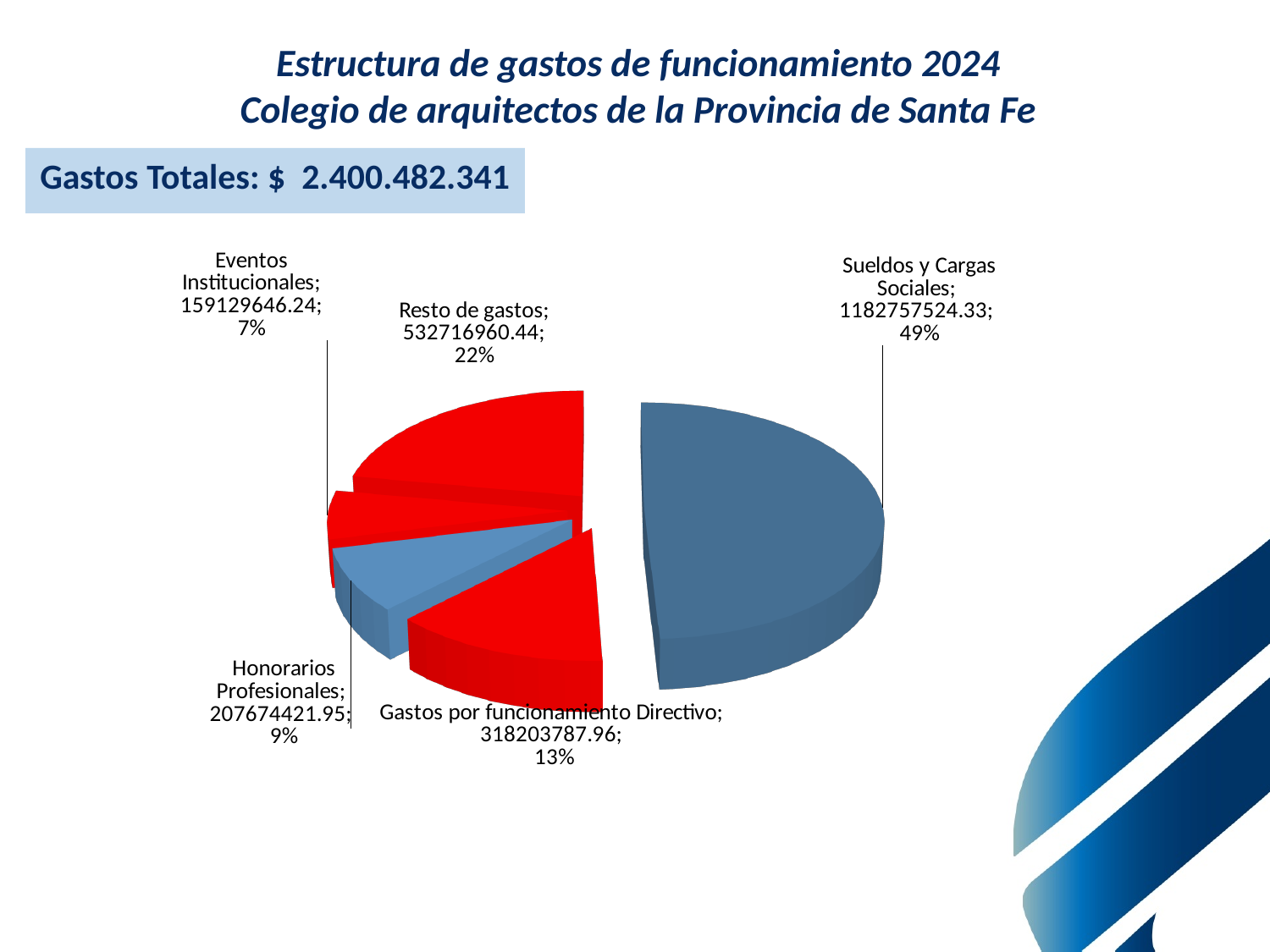
What is the value shown for Sueldos y Cargas Sociales? 1182757524.33 What is the value shown for Gastos por funcionamiento Directivo? 318203787.96 What percentage of the pie does Resto de gastos represent? 22% What total expenditure (Gastos Totales) is stated on the slide? $ 2.400.482.341 What kind of chart is shown on the slide? Pie chart What percentage of the pie does Eventos Institucionales represent? 7% Which category has the largest share of the pie? Sueldos y Cargas Sociales Which is larger, the share for Honorarios Profesionales or the share for Gastos por funcionamiento Directivo? Gastos por funcionamiento Directivo Which category has the smallest share of the pie? Eventos Institucionales What is the value shown for Honorarios Profesionales? 207674421.95 What is the difference in percentage points between the share for Sueldos y Cargas Sociales and the share for Resto de gastos? 27 percentage points How many slices does the pie chart have? 5